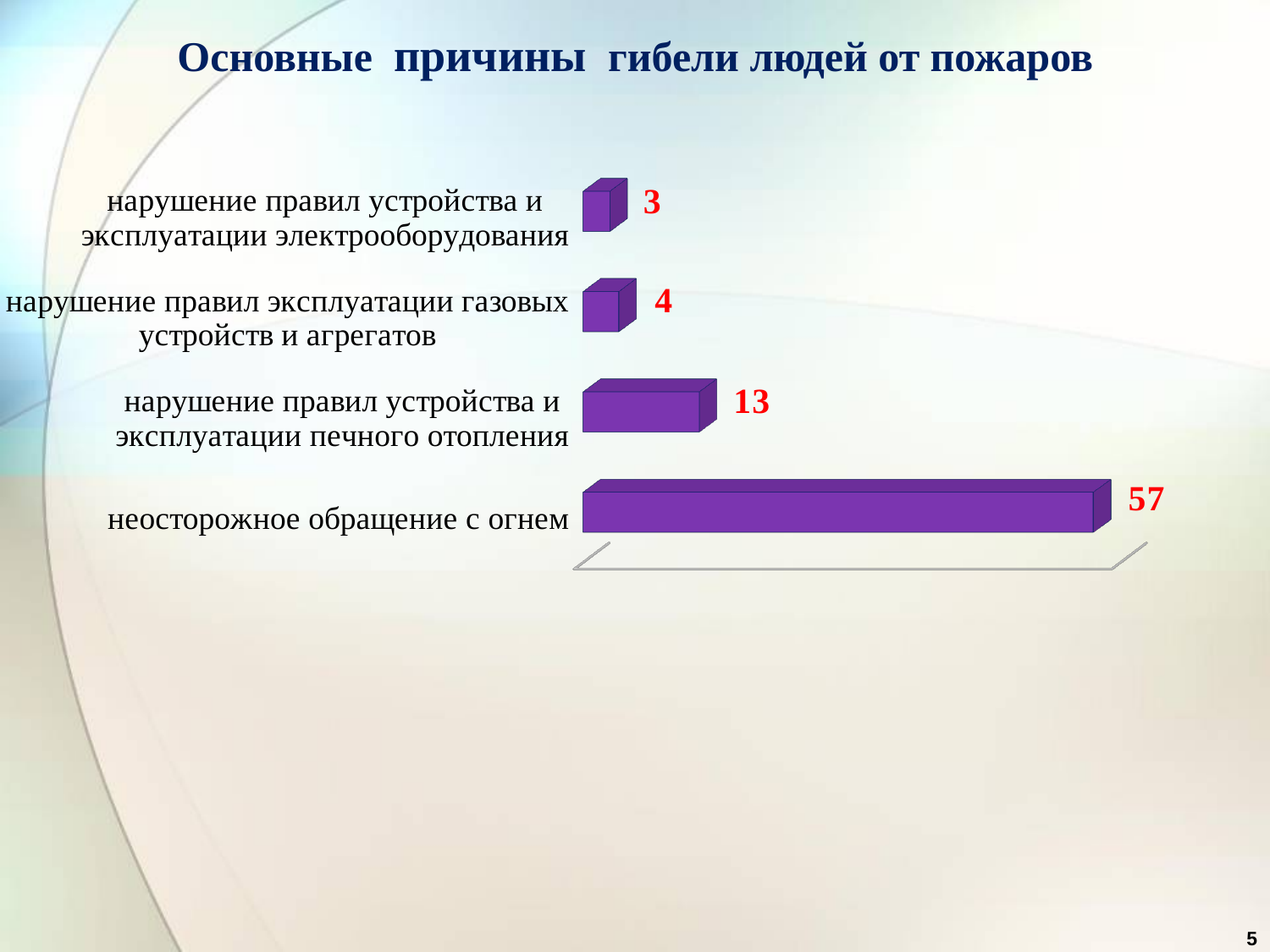
What is the difference between the values for «неосторожное обращение с огнем» and «нарушение правил устройства и эксплуатации печного отопления»? 44 What is the title of the slide? Основные причины гибели людей от пожаров What is the value for «нарушение правил устройства и эксплуатации печного отопления»? 13 What is the value for «нарушение правил эксплуатации газовых устройств и агрегатов»? 4 What kind of chart is shown on the slide? bar chart How many categories are shown in the chart? 4 What is the value for «неосторожное обращение с огнем»? 57 What is the difference between the values for «нарушение правил эксплуатации газовых устройств и агрегатов» and «нарушение правил устройства и эксплуатации электрооборудования»? 1 What is the value for «нарушение правил устройства и эксплуатации электрооборудования»? 3 Which category has the lowest value? нарушение правил устройства и эксплуатации электрооборудования Which category has the highest value? неосторожное обращение с огнем Which is larger: the value for «нарушение правил устройства и эксплуатации печного отопления» or for «нарушение правил эксплуатации газовых устройств и агрегатов»? нарушение правил устройства и эксплуатации печного отопления